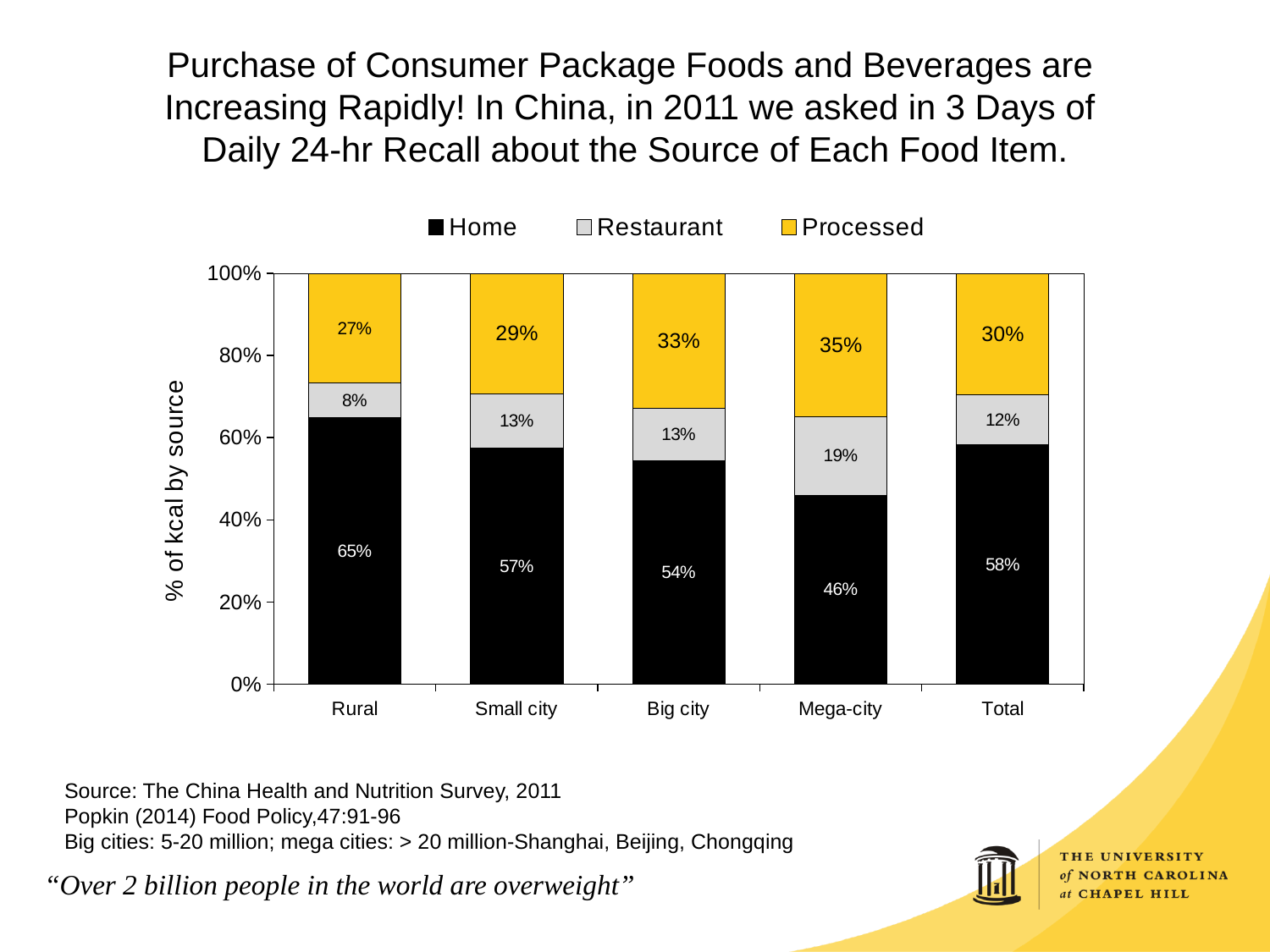
What percentage of kcal comes from Home in Rural areas? 65% How many categories are shown on the x axis? 5 Is the Home share larger for Big city or Mega-city? Big city Does the Home share rise or fall from Rural to Mega-city? Fall What is the difference between the Processed share for Mega-city and for Rural? 8% Which category has the lowest Restaurant share? Rural How many series does the legend list? 3 What is the y-axis label of the chart? % of kcal by source What is the Processed share for Mega-city? 35% Which category has the highest Home share? Rural What is the Restaurant value for Small city? 13% What kind of chart is shown? Stacked bar chart